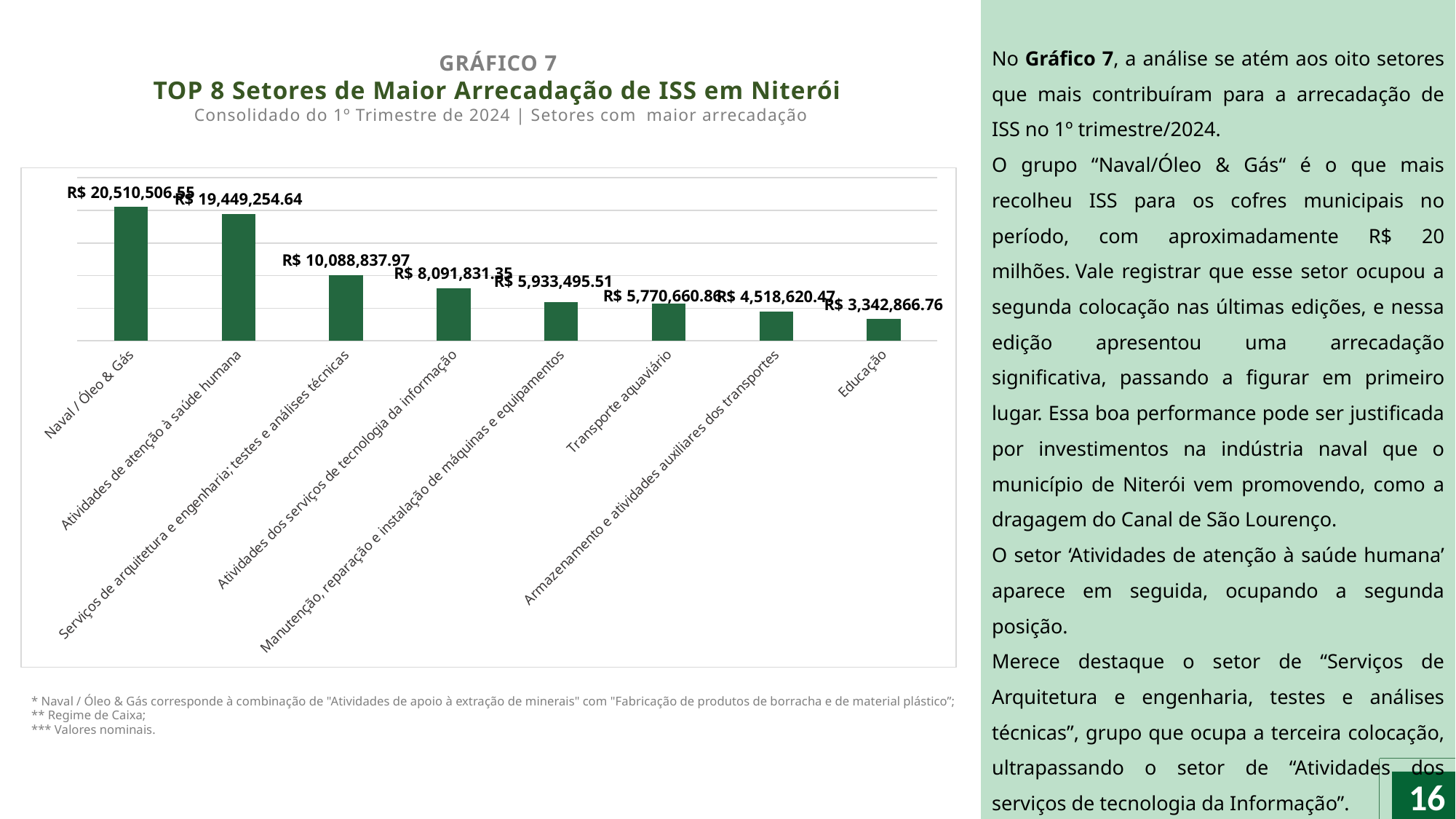
What is the ISS value for Atividades de atenção à saúde humana? R$ 19,449,254.64 Which sector has the lowest ISS value? Educação What type of chart is shown on the slide? Bar chart Which sector has the highest ISS value? Naval / Óleo & Gás What is the ISS value for Educação? R$ 3,342,866.76 What is the ISS value for Atividades dos serviços de tecnologia da informação? R$ 8,091,831.35 Which is larger, the value for Armazenamento e atividades auxiliares dos transportes or the value for Educação? Armazenamento e atividades auxiliares dos transportes What is the ISS value for Naval / Óleo & Gás? R$ 20,510,506.55 How many sectors are plotted in the chart? 8 What is the difference between the values for Naval / Óleo & Gás and Atividades de atenção à saúde humana? R$ 1,061,251.91 What is the difference between the values for Serviços de arquitetura e engenharia; testes e análises técnicas and Atividades dos serviços de tecnologia da informação? R$ 1,997,006.62 Do the values rise or fall from left to right across the chart? Fall